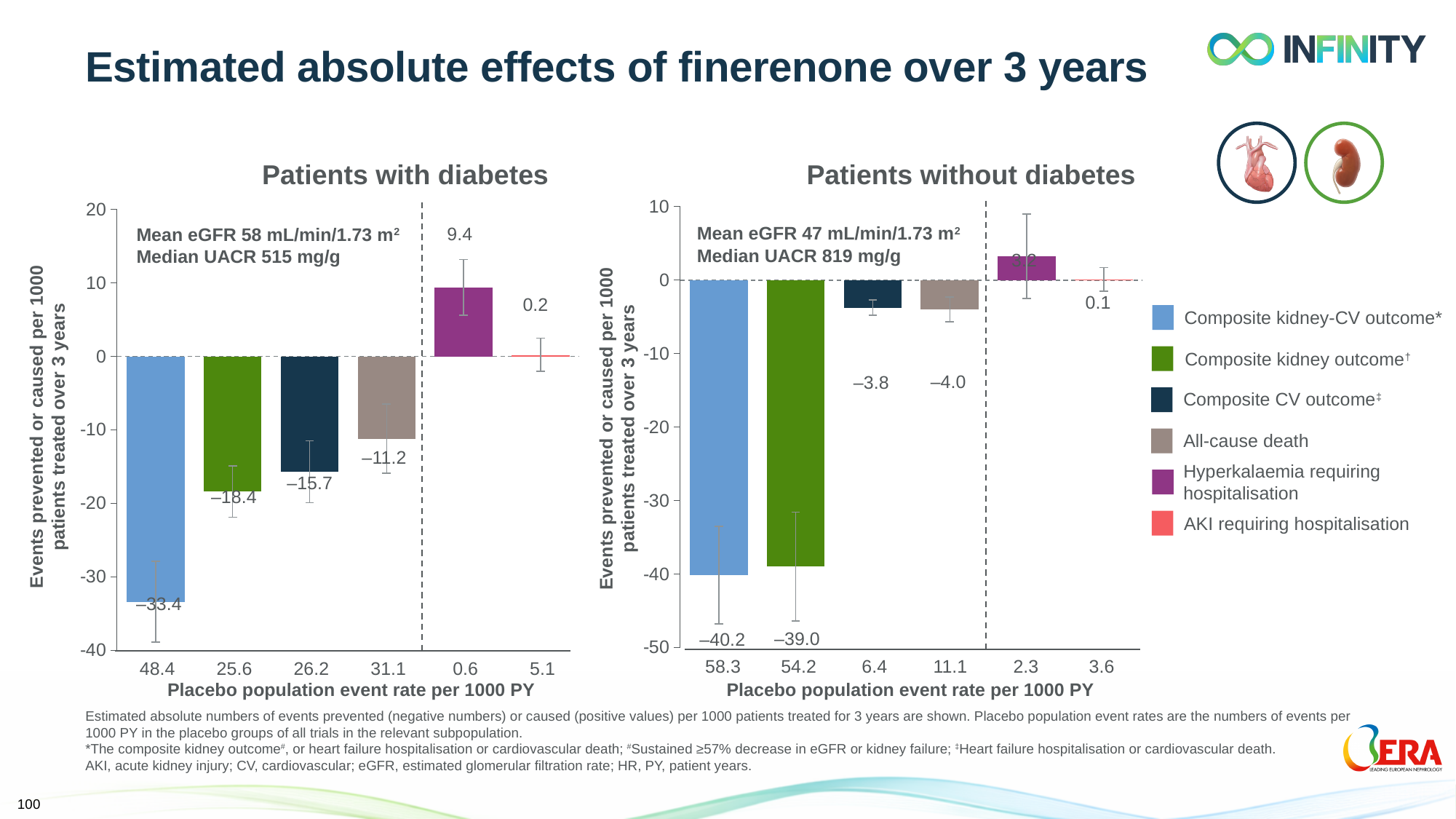
In the 'Patients without diabetes' chart, what is the value for AKI requiring hospitalisation? 0.1 In the 'Patients with diabetes' chart, which is larger in magnitude: the value for all-cause death or the value for the composite CV outcome? Composite CV outcome In the 'Patients with diabetes' chart, what is the value for hyperkalaemia requiring hospitalisation? 9.4 What type of chart is used for 'Patients with diabetes'? Bar chart In the 'Patients without diabetes' chart, what is the value for the composite kidney outcome? –39.0 In the 'Patients with diabetes' chart, which outcome has the lowest (most negative) value? Composite kidney-CV outcome In the 'Patients without diabetes' chart, which outcome has the lowest (most negative) value? Composite kidney-CV outcome In the 'Patients with diabetes' chart, what is the value for the composite kidney-CV outcome? –33.4 In the 'Patients with diabetes' chart, what is the difference between the values for the composite kidney outcome (–18.4) and the composite CV outcome (–15.7)? 2.7 In the 'Patients with diabetes' chart, what is the placebo population event rate per 1000 PY shown for the composite kidney-CV outcome? 48.4 What mean eGFR is stated for the 'Patients without diabetes' chart? 47 mL/min/1.73 m² How many entries does the legend list? 6